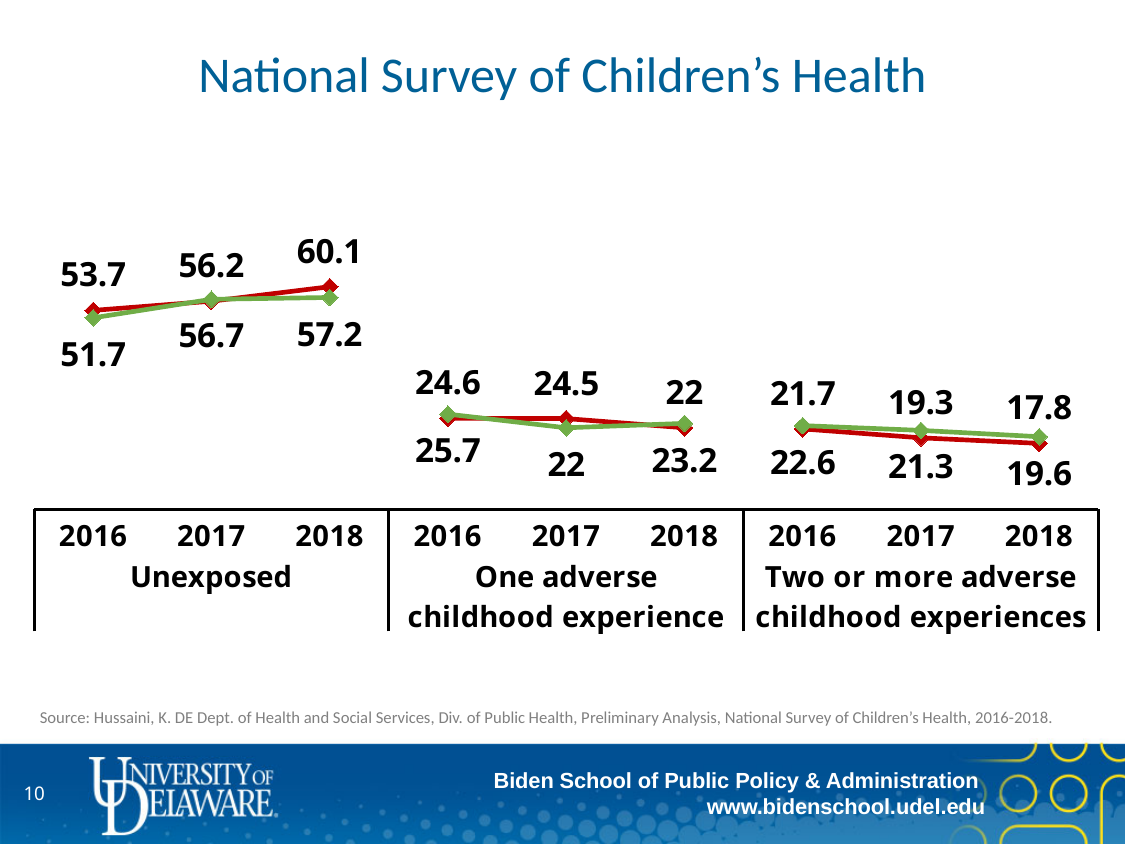
What value does the red line show for 2018 in the Unexposed group? 60.1 By how much does the red line's value in the Unexposed group increase from 2016 to 2018? 6.4 What value does the green line show for 2016 in the Unexposed group? 51.7 What is the title of the chart on the slide? National Survey of Children's Health What is the highest value labelled on the chart? 60.1 What kind of chart is shown on the slide? line chart What value does the red line show for 2017 in the One adverse childhood experience group? 24.5 What value does the green line show for 2018 in the Two or more adverse childhood experiences group? 19.6 What is the lowest value labelled on the chart? 17.8 In the Unexposed group for 2016, which line has the larger value, the red line or the green line? red line Does the red line rise or fall from 2016 to 2018 in the Two or more adverse childhood experiences group? fall How many groups of years are shown along the x axis of the chart? 3